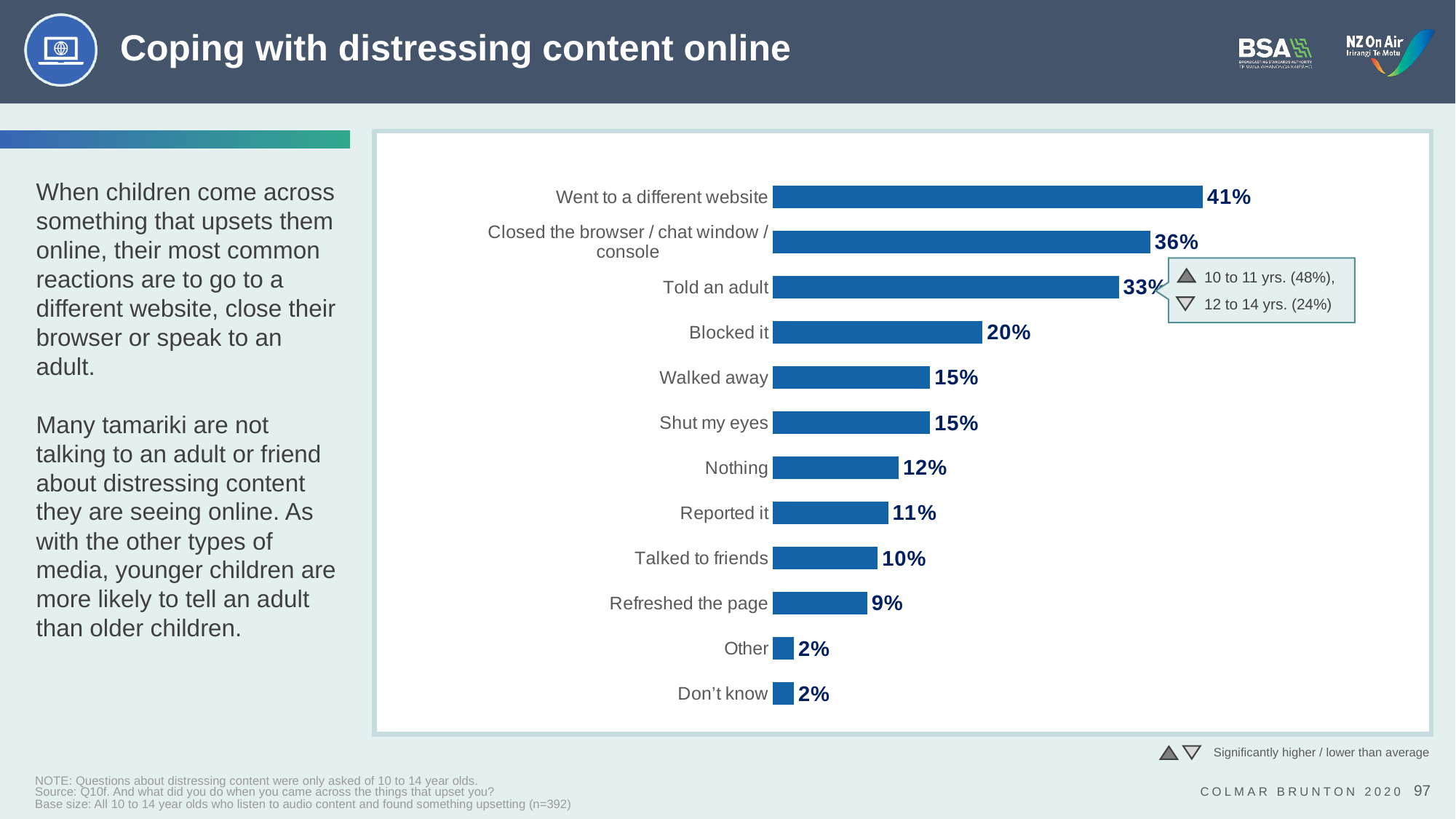
Which reaction has the highest percentage? Went to a different website What kind of chart is shown on the slide? Bar chart What is the difference between 'Went to a different website' and 'Closed the browser / chat window / console'? 5% Which is larger, 'Nothing' or 'Reported it'? Nothing What is the difference between 'Told an adult' and 'Talked to friends'? 23% What percentage of children went to a different website when they came across upsetting content? 41% What percentage of children blocked the upsetting content? 20% According to the callout, what percentage of 12 to 14 year olds told an adult? 24% According to the callout, what percentage of 10 to 11 year olds told an adult? 48% What is the value for 'Refreshed the page'? 9% What is the value for 'Told an adult'? 33% How many categories are shown in the chart? 12